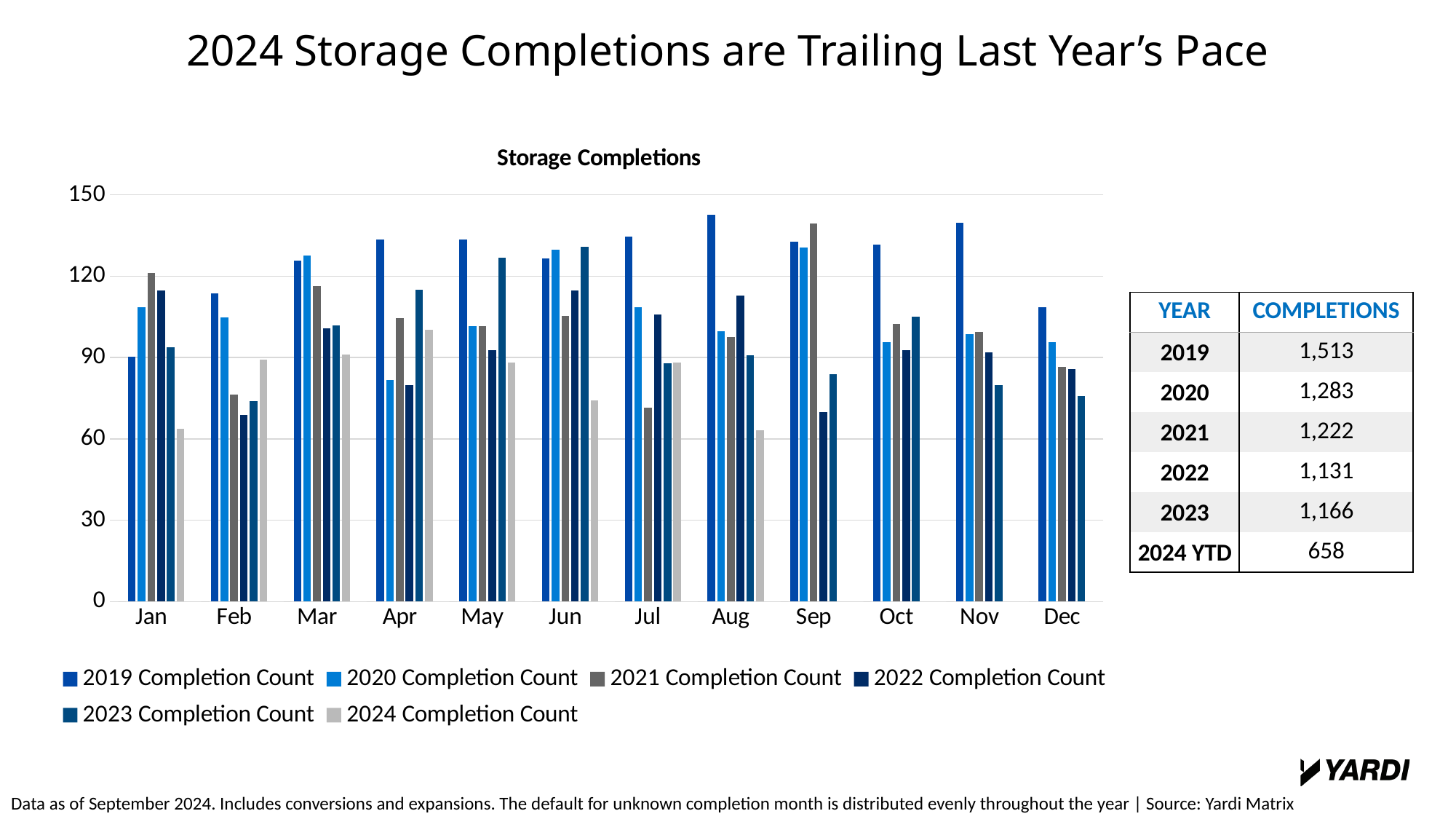
Is the 2019 Completion Count value for Aug greater or less than 120? greater What is the title of the chart? Storage Completions How many months are shown on the x axis of the chart? 12 What kind of chart is shown on the slide? bar chart In which month is the 2019 Completion Count bar the lowest? Jan How many series does the chart legend list? 6 Is the 2024 Completion Count value for Jun greater or less than 90? less In Sep, which is larger: the 2021 Completion Count or the 2022 Completion Count? 2021 Completion Count How many months have a 2024 Completion Count bar in the chart? 8 From Jan to Apr, do the 2024 Completion Count bars rise or fall? rise Is the 2022 Completion Count value for Sep greater or less than 90? less In which month is the 2021 Completion Count bar the highest? Sep